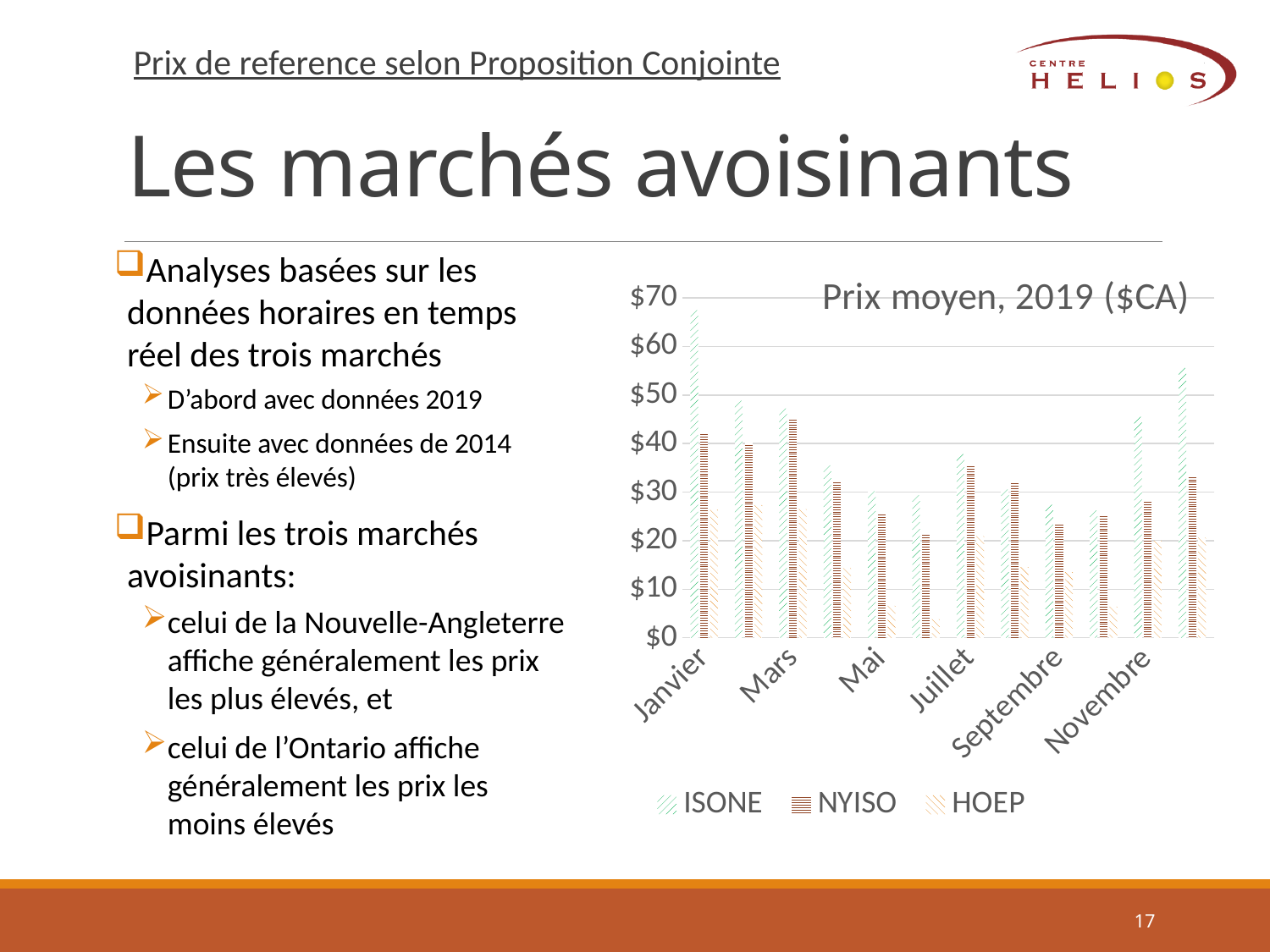
Is the ISONE value for Janvier greater or less than $60? greater What is the title of the chart? Prix moyen, 2019 ($CA) In which month does ISONE reach its highest value? Janvier What kind of chart is shown on the slide? bar chart Which series has the highest value in Janvier? ISONE Do the ISONE values rise or fall from Janvier to Mai? fall Is the NYISO value for Mars greater or less than $40? greater Which series has the lowest value in Janvier? HOEP Which series are listed in the chart legend? ISONE, NYISO, HOEP Which is larger in Novembre, the ISONE value or the HOEP value? ISONE How many series does the chart legend list? 3 Is the HOEP value for Mai greater or less than $20? less